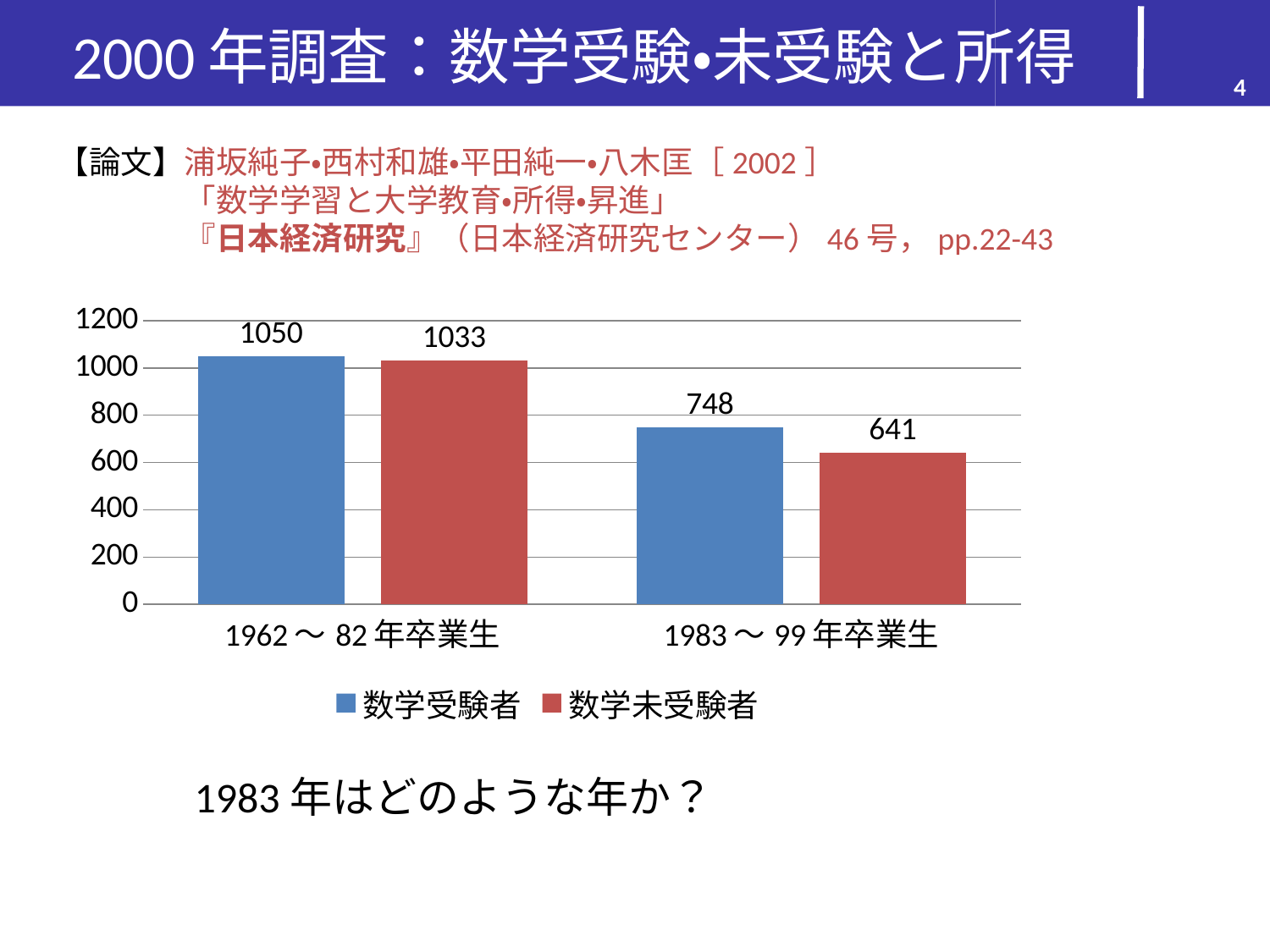
Which bar has the highest value in the chart? 数学受験者, 1962～82年卒業生 What is the value for 数学未受験者 among 1962～82年卒業生? 1033 For 1983～99年卒業生, which is larger: 数学受験者 or 数学未受験者? 数学受験者 What is the value for 数学未受験者 among 1983～99年卒業生? 641 Which bar has the lowest value in the chart? 数学未受験者, 1983～99年卒業生 What is the value for 数学受験者 among 1962～82年卒業生? 1050 How many series does the legend list? 2 What is the difference between 数学受験者 and 数学未受験者 for 1962～82年卒業生? 17 What kind of chart is shown on the slide? Bar chart What is the difference between 数学受験者 and 数学未受験者 for 1983～99年卒業生? 107 How many categories are shown on the x axis? 2 What is the value for 数学受験者 among 1983～99年卒業生? 748